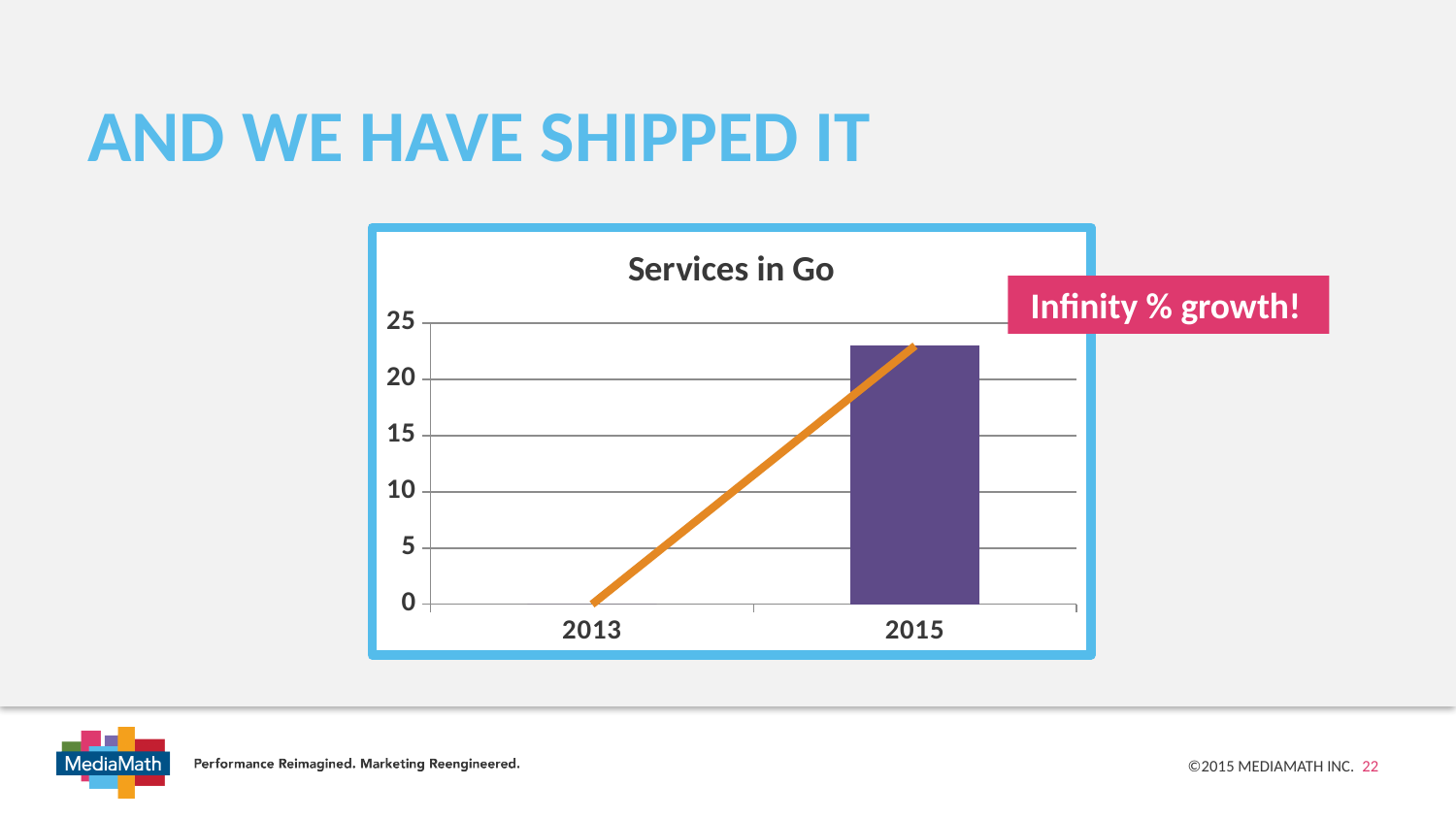
What is the value for 2013 in the chart? 0 What does the pink callout next to the chart say? Infinity % growth! Is the value for 2015 greater or less than 20? greater Which is larger, the value for 2013 or the value for 2015? 2015 What is the highest value labelled on the y axis of the chart? 25 Which year has the highest value in the chart? 2015 What is the title of the chart? Services in Go How many categories are shown on the x axis of the chart? 2 Is the value for 2015 greater or less than 25? less Which year has the lowest value in the chart? 2013 What kind of chart is shown on the slide? bar chart Do the values rise or fall from 2013 to 2015? rise